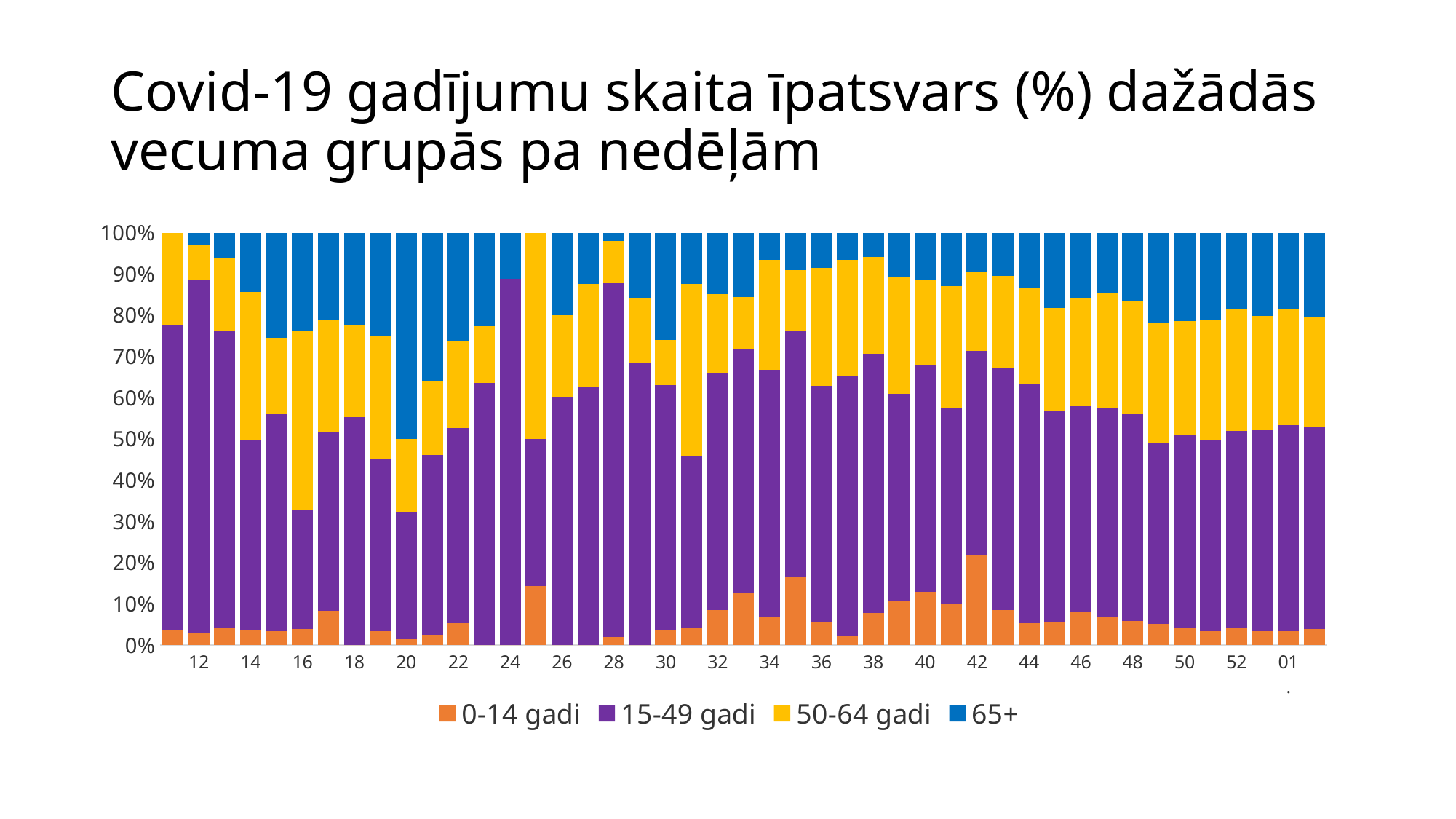
What is the title of the chart? Covid-19 gadījumu skaita īpatsvars (%) dažādās vecuma grupās pa nedēļām Which colour represents the 65+ age group in the chart? Blue Which is larger: the 0-14 gadi share in week 42 or in week 14? Week 42 Which week has the largest share for 0-14 gadi? 42 Is the share for 65+ in week 12 greater or less than 10%? less How many series does the legend list? 4 Is the share for 0-14 gadi in week 42 greater or less than 15%? greater What kind of chart is shown on the slide? Stacked bar chart Is the share for 65+ in week 20 greater or less than 40%? greater Which week has the largest share for 65+? 20 Which is larger: the 65+ share in week 20 or in week 12? Week 20